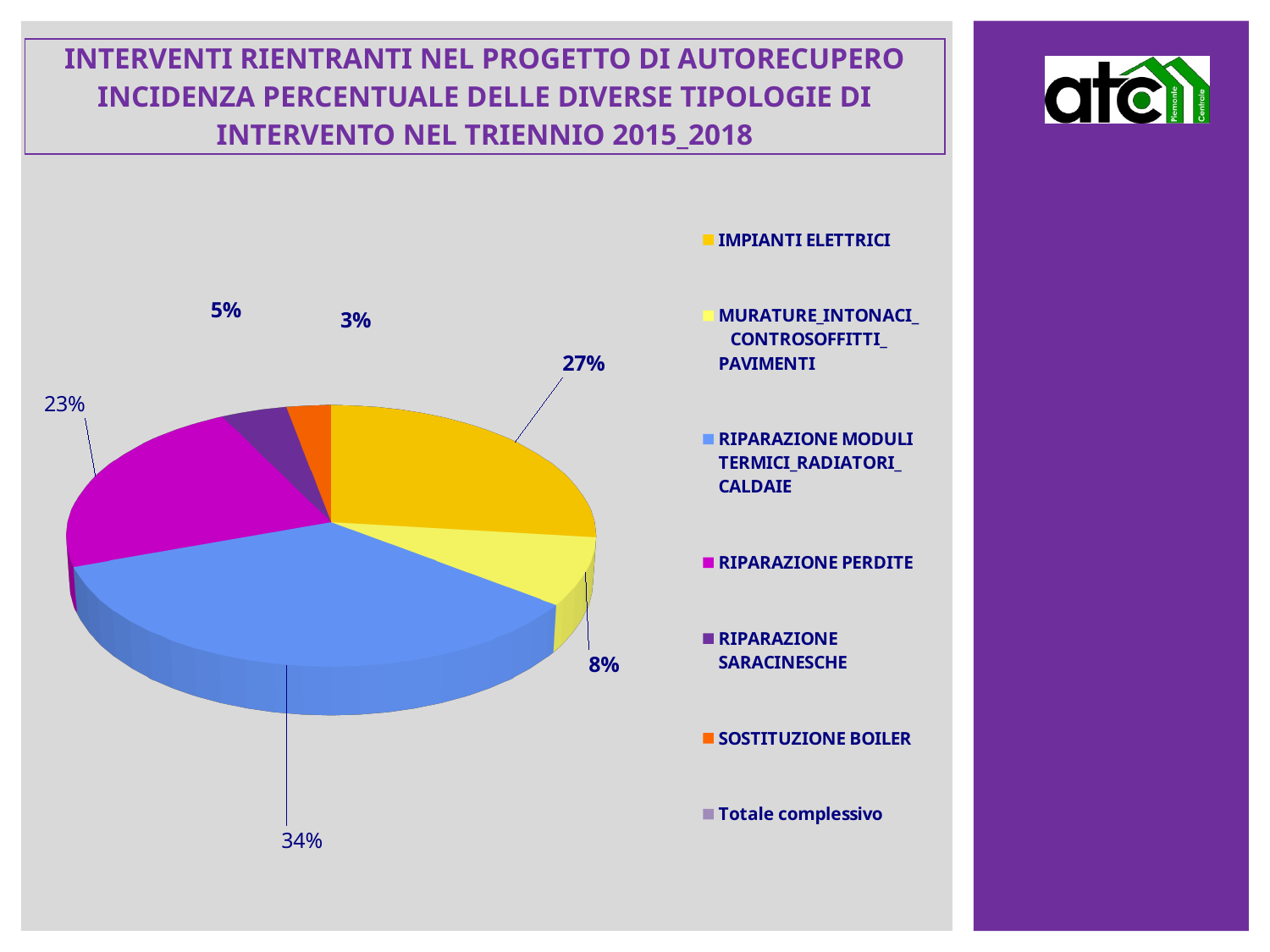
What share of the pie does SOSTITUZIONE BOILER have? 3% How many entries does the legend list? 7 What share of the pie does MURATURE_INTONACI_CONTROSOFFITTI_PAVIMENTI have? 8% Which category has the largest slice of the pie? RIPARAZIONE MODULI TERMICI_RADIATORI_CALDAIE Which is larger, the slice for RIPARAZIONE PERDITE or the slice for IMPIANTI ELETTRICI? IMPIANTI ELETTRICI What share of the pie does RIPARAZIONE MODULI TERMICI_RADIATORI_CALDAIE have? 34% What share of the pie does IMPIANTI ELETTRICI have? 27% Which category has the smallest slice of the pie? SOSTITUZIONE BOILER What share of the pie does RIPARAZIONE PERDITE have? 23% What kind of chart is shown on the slide? pie chart What is the difference in percentage points between RIPARAZIONE MODULI TERMICI_RADIATORI_CALDAIE and IMPIANTI ELETTRICI? 7 What colour is the slice for RIPARAZIONE SARACINESCHE? purple